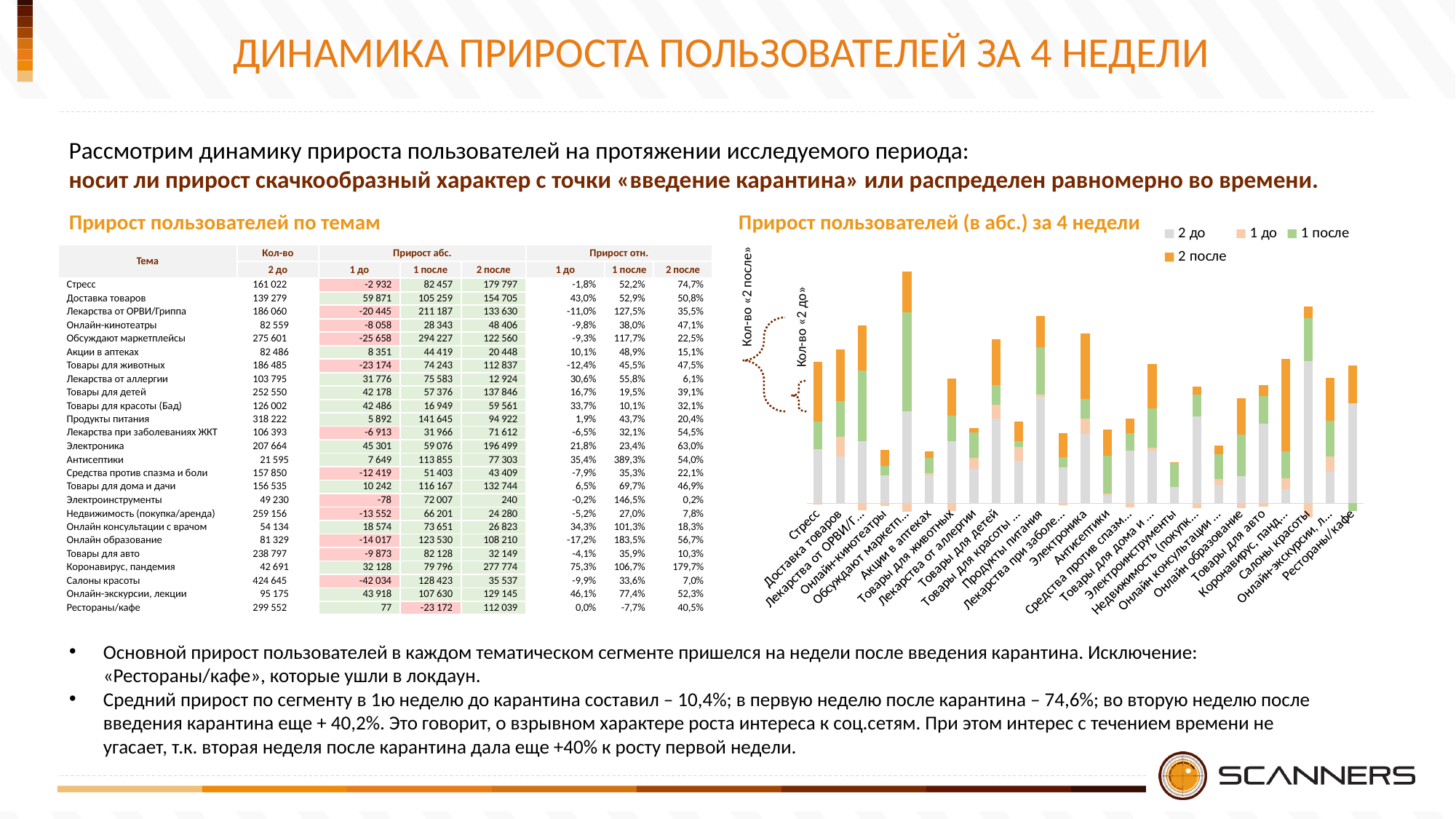
On the chart 'Прирост пользователей (в абс.) за 4 недели', which stacked bar is taller: Коронавирус, пандемия or Акции в аптеках? Коронавирус, пандемия What is the first entry in the legend of the chart 'Прирост пользователей (в абс.) за 4 недели'? 2 до On the chart 'Прирост пользователей (в абс.) за 4 недели', which stacked bar is taller: Салоны красоты or Электроинструменты? Салоны красоты Which series is shown in orange on the chart 'Прирост пользователей (в абс.) за 4 недели'? 2 после What kind of chart is 'Прирост пользователей (в абс.) за 4 недели'? stacked bar chart How many series does the legend of the chart 'Прирост пользователей (в абс.) за 4 недели' list? 4 How many categories (bars) are shown on the chart 'Прирост пользователей (в абс.) за 4 недели'? 25 On the chart 'Прирост пользователей (в абс.) за 4 недели', which category has the tallest stacked bar? Обсуждают маркетплейсы On the chart 'Прирост пользователей (в абс.) за 4 недели', which stacked bar is taller: Стресс or Онлайн-кинотеатры? Стресс